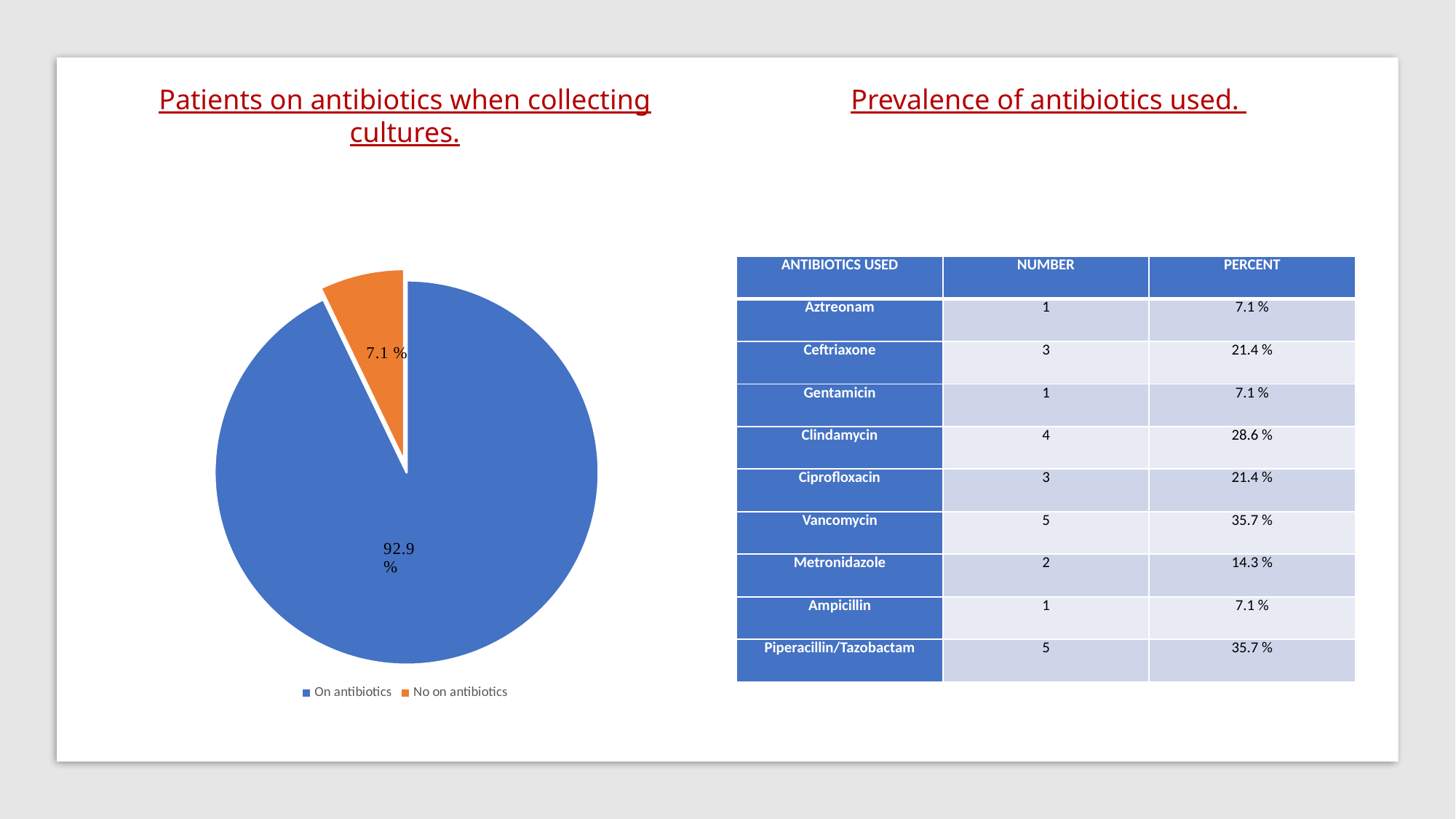
Which slice of the pie chart is the smallest? No on antibiotics How many slices does the pie chart have? 2 How many entries does the legend of the pie chart list? 2 In the pie chart, what percentage of patients were not on antibiotics? 7.1 % Which slice of the pie chart is the largest? On antibiotics In the pie chart, which is larger: the share for "On antibiotics" or the share for "No on antibiotics"? On antibiotics What is the title above the pie chart? Patients on antibiotics when collecting cultures. What kind of chart is shown under the title "Patients on antibiotics when collecting cultures."? pie chart In the pie chart, what percentage of patients were on antibiotics? 92.9 % What is the difference in percentage points between the "On antibiotics" slice and the "No on antibiotics" slice in the pie chart? 85.8 What colour is the "No on antibiotics" slice in the pie chart? orange